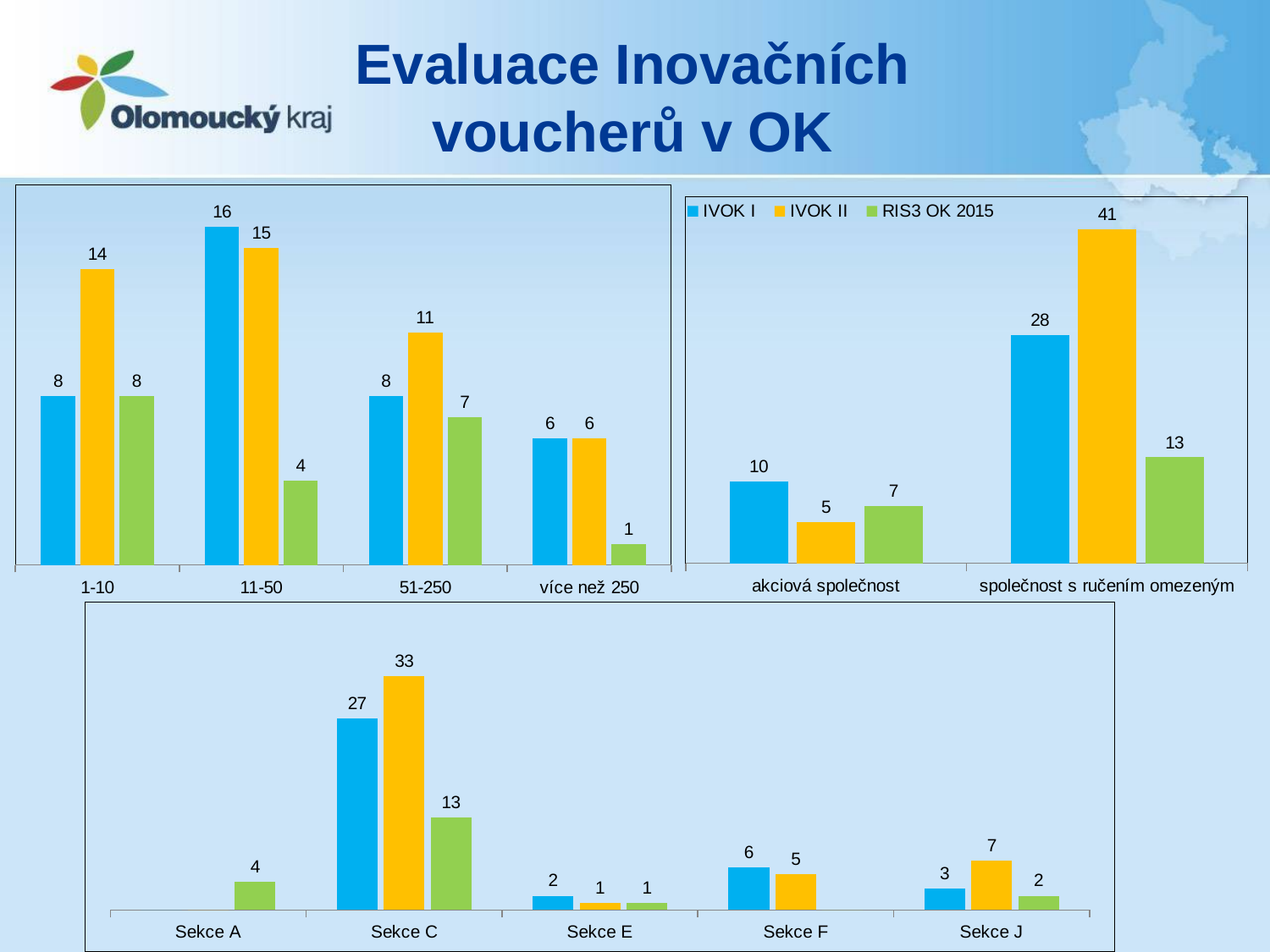
In the top-left chart, what is the IVOK II value for the 11-50 category? 15 In the top-right chart, what is the difference between the IVOK II and IVOK I values for 'společnost s ručením omezeným'? 13 In the top-left chart, what is the difference between the IVOK I and RIS3 OK 2015 values for the 11-50 category? 12 What type of chart is the bottom chart? Bar chart In the bottom chart, which category has the highest RIS3 OK 2015 value? Sekce C How many categories are shown on the x axis of the bottom chart? 5 In the bottom chart, what is the IVOK II value for Sekce C? 33 In the top-right chart, which series has the lowest value for 'akciová společnost'? IVOK II How many series does the legend in the top-right chart list? 3 In the top-right chart, what is the IVOK II value for 'společnost s ručením omezeným'? 41 In the top-left chart, what is the RIS3 OK 2015 value for the 'více než 250' category? 1 In the top-left chart, which category has the highest IVOK I value? 11-50